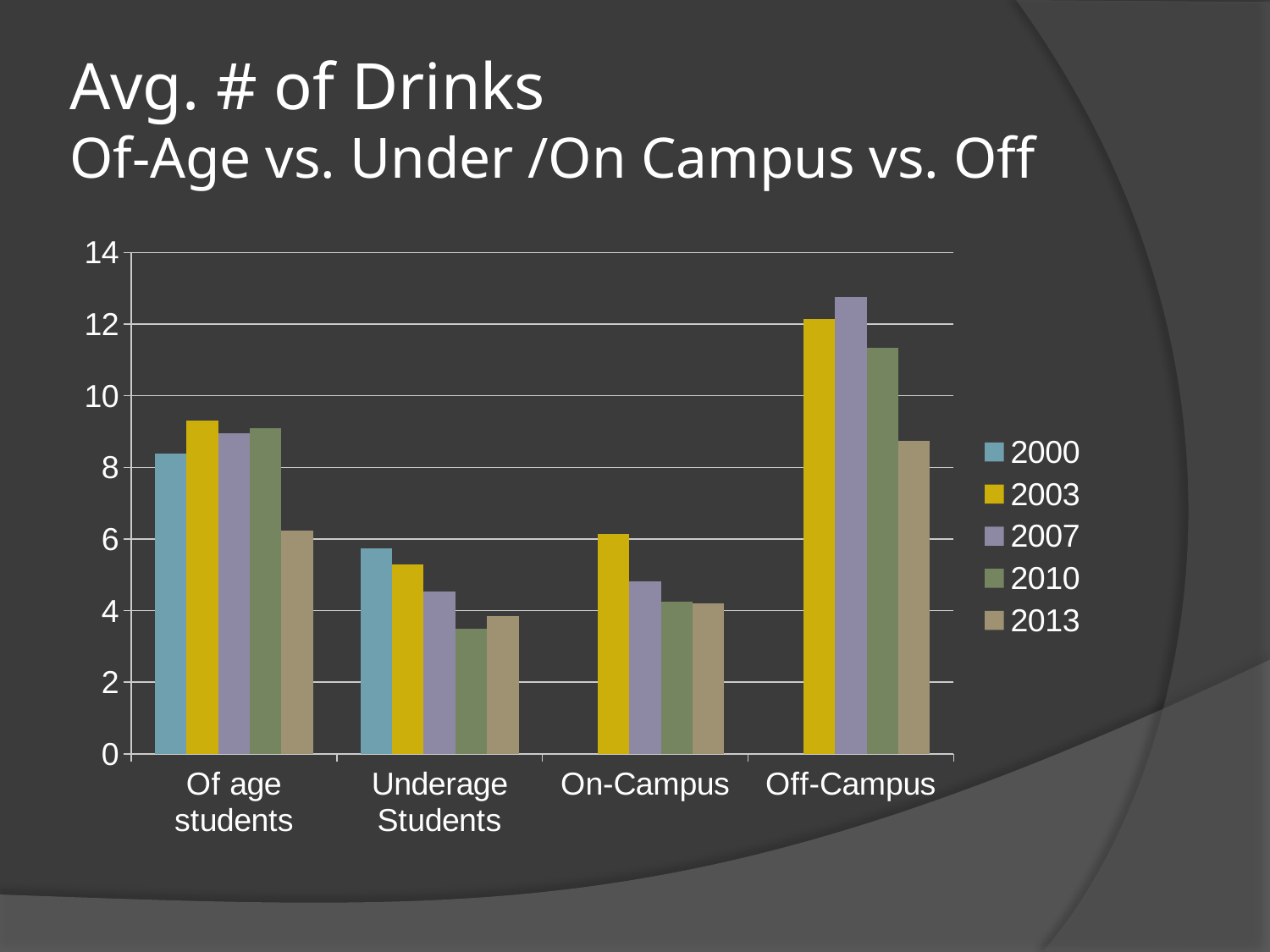
Which is larger in 2003: Of age students or Underage Students? Of age students How many series does the legend list? 5 Which category has the highest bar for 2007? Off-Campus Which year has the highest bar for Off-Campus? 2007 Is the value for Off-Campus in 2007 greater or less than 12? greater Is the value for Of age students in 2013 greater or less than 8? less What colour represents 2003 in the legend? yellow Which year has the lowest bar for Of age students? 2013 What kind of chart is shown on the slide? bar chart How many categories are shown on the x axis? 4 Is the value for On-Campus in 2007 greater or less than 6? less Do the Underage Students bars rise or fall from 2000 to 2010? fall